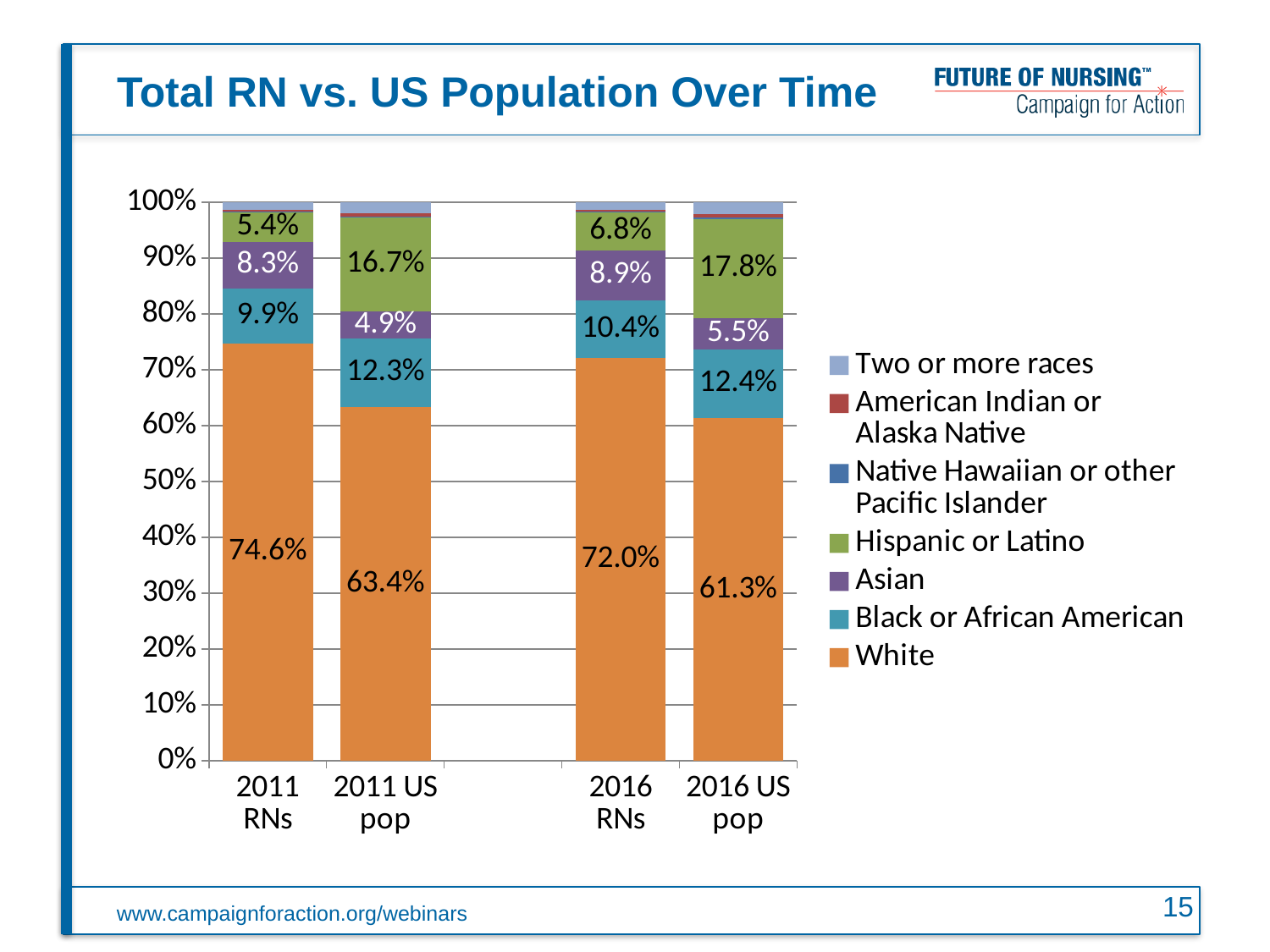
What is the Hispanic or Latino share of the 2016 US pop bar? 17.8% Which has the larger Black or African American share, 2011 RNs or 2011 US pop? 2011 US pop Which bar has the highest White share? 2011 RNs What percentage of 2011 RNs were White? 74.6% What is the Asian share shown for 2011 US pop? 4.9% How much larger is the Hispanic or Latino share for 2016 US pop than for 2016 RNs? 11.0 percentage points How many series does the legend list? 7 Which bar has the lowest White share? 2016 US pop What kind of chart is shown on the slide? Stacked bar chart How many bars are plotted on the chart? 4 By how many percentage points did the White share of RNs fall from 2011 to 2016? 2.6 percentage points What is the Black or African American share for 2016 RNs? 10.4%